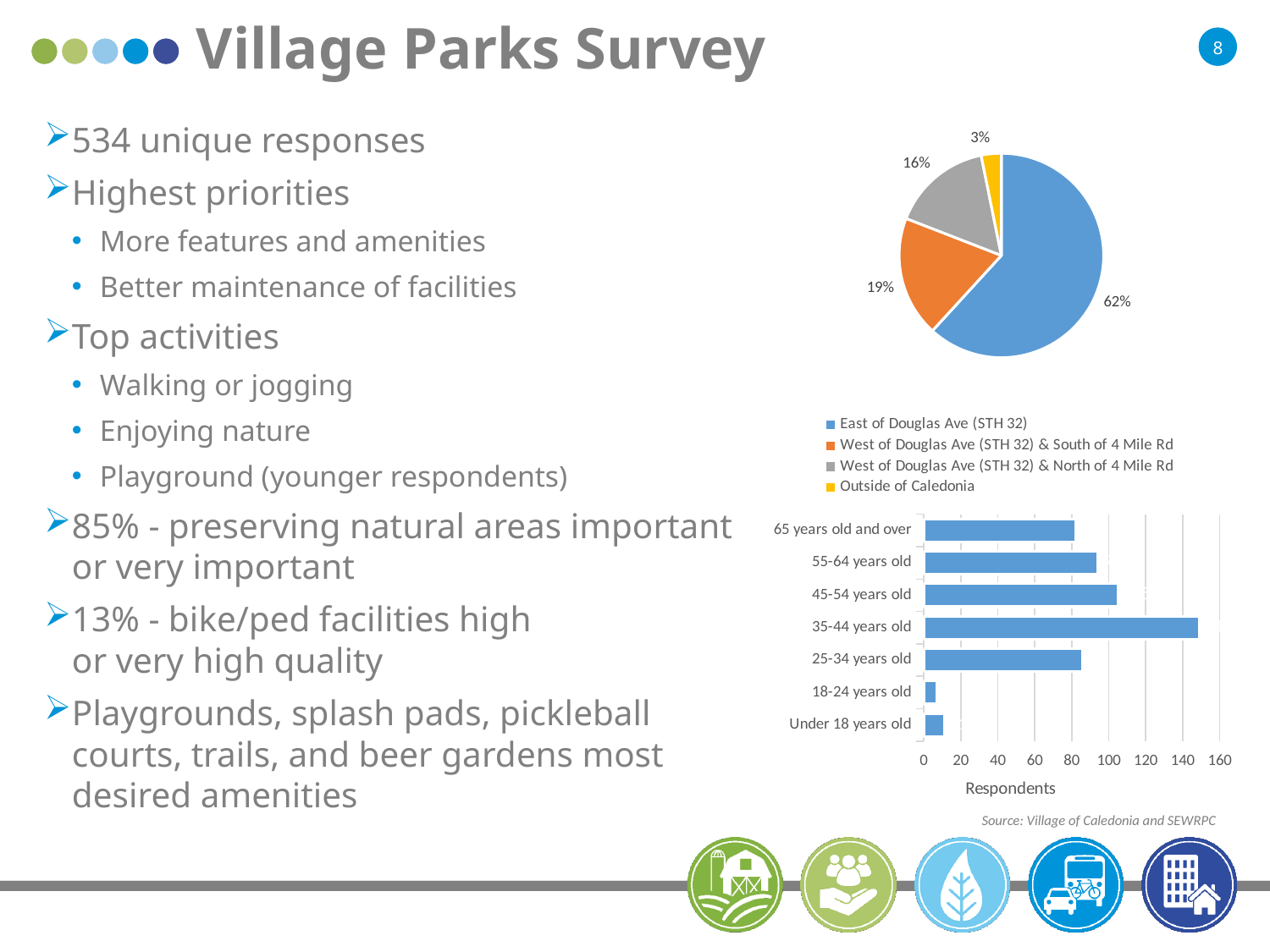
In the pie chart, which area has the largest share of respondents? East of Douglas Ave (STH 32) In the bar chart of respondents by age group, is the value for 35-44 years old greater or less than 140? greater In the pie chart, what share of respondents are from West of Douglas Ave (STH 32) & North of 4 Mile Rd? 16% In the pie chart, what share of respondents are from East of Douglas Ave (STH 32)? 62% In the bar chart of respondents by age group, which age group has the most respondents? 35-44 years old In the pie chart, what share of respondents are from Outside of Caledonia? 3% In the pie chart, what is the difference between the share for West of Douglas Ave (STH 32) & South of 4 Mile Rd and the share for West of Douglas Ave (STH 32) & North of 4 Mile Rd? 3% In the bar chart of respondents by age group, is the value for 45-54 years old greater or less than 100? greater What kind of chart is the bottom-right chart showing respondents by age group? bar chart In the bar chart of respondents by age group, which age group has the fewest respondents? 18-24 years old How many categories does the pie chart's legend list? 4 How many age groups are shown in the bar chart of respondents? 7